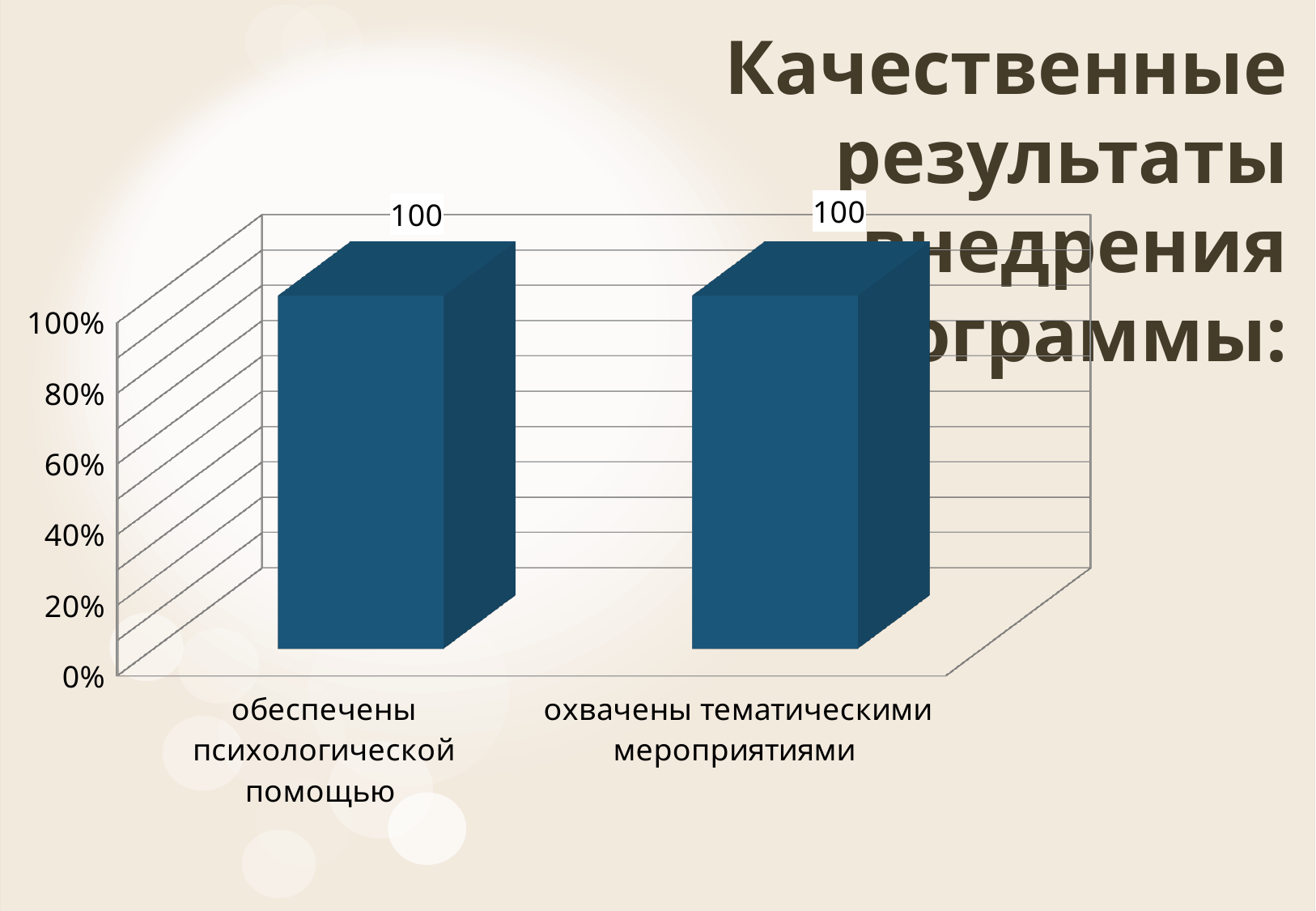
What kind of chart is shown on the slide? bar chart What is the value for the category "обеспечены психологической помощью"? 100 What is the highest value shown on the vertical axis of the chart? 100% Is the value for "обеспечены психологической помощью" greater or less than 80%? greater What colour are the bars in the chart? blue What is the value for the category "охвачены тематическими мероприятиями"? 100 How many categories are shown on the chart? 2 What is the difference between the values for "обеспечены психологической помощью" and "охвачены тематическими мероприятиями"? 0 Is the value for "охвачены тематическими мероприятиями" greater or less than 60%? greater